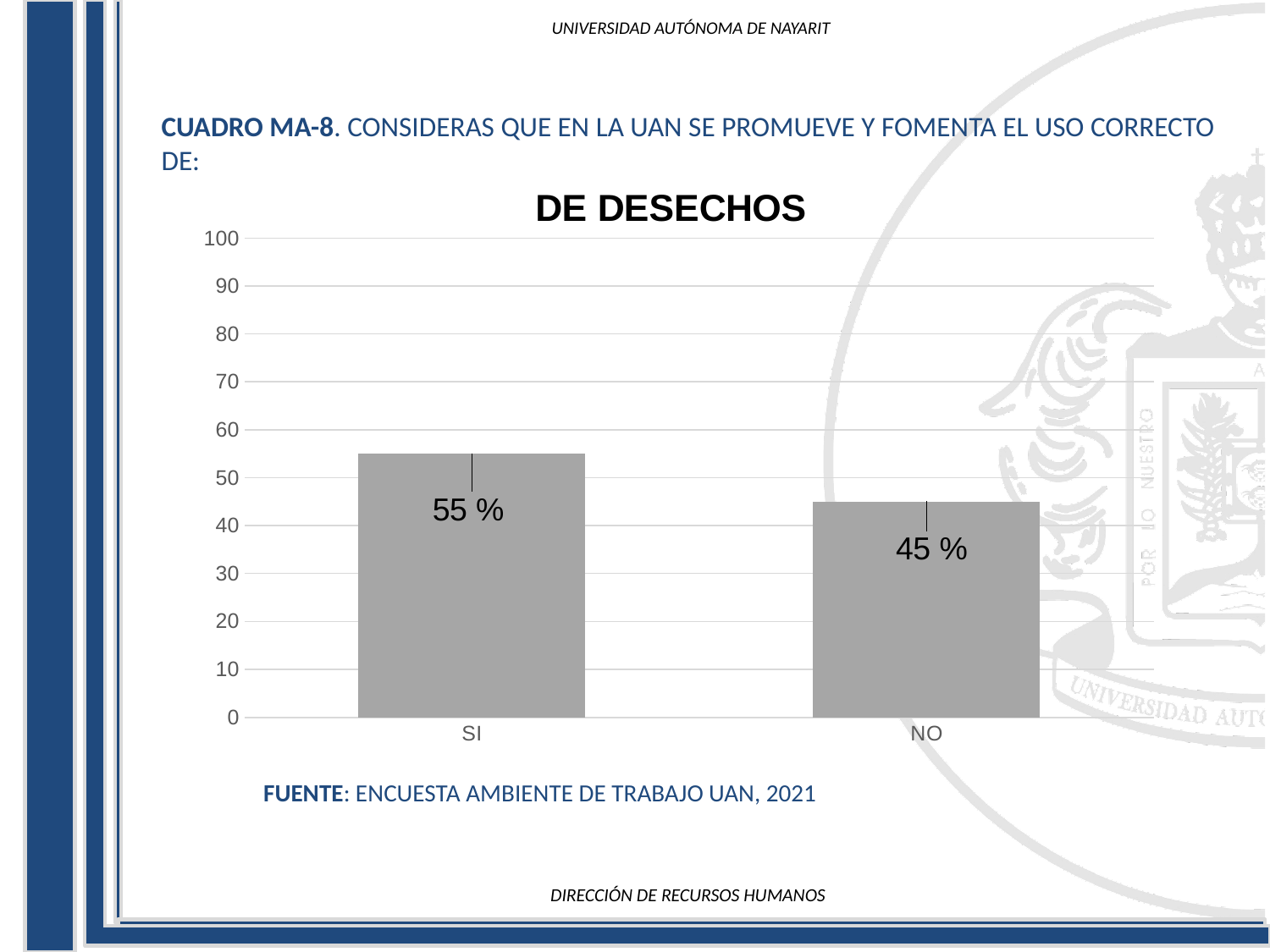
Is the value for NO greater or less than 50? less How many categories are shown on the x axis? 2 Which category has the highest value? SI Which category has the lowest value? NO What kind of chart is shown? bar chart Which is larger, the value for SI or the value for NO? SI What is the difference between the values for SI and NO? 10 % Is the value for SI greater or less than 50? greater What is the value for NO? 45 % What is the title of the chart? DE DESECHOS What is the value for SI? 55 % What is the maximum value shown on the y axis? 100